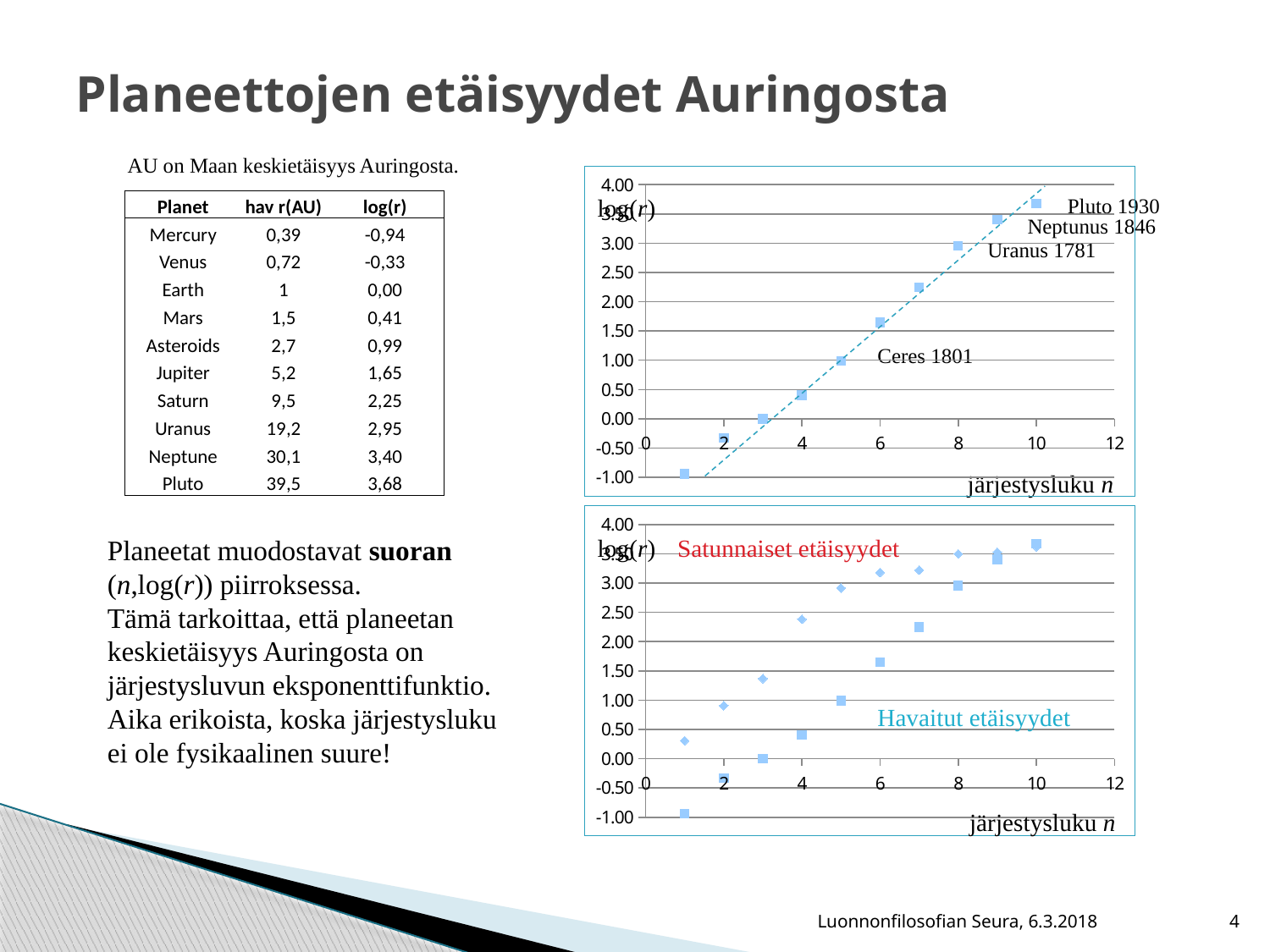
In the top chart, which planet is annotated with the year 1930? Pluto In the top chart, is the log(r) value at n = 1 greater or less than 0.00? less In the top chart, how many data points are plotted? 10 What kind of chart is the top chart on the slide? scatter chart In the top chart, what is the log(r) value at järjestysluku n = 3? 0.00 In the top chart, at which järjestysluku n is the log(r) value lowest? 1 In the top chart, is the log(r) value at n = 10 greater or less than 3.00? greater In the bottom chart, at n = 4, which series has the larger value: Satunnaiset etäisyydet or Havaitut etäisyydet? Satunnaiset etäisyydet In the bottom chart, is the Havaitut etäisyydet value at n = 8 greater or less than 2.50? greater How many data series are shown in the bottom chart? 2 In the top chart, do the log(r) values rise or fall as järjestysluku n increases? rise In the top chart, at which järjestysluku n is the log(r) value highest? 10